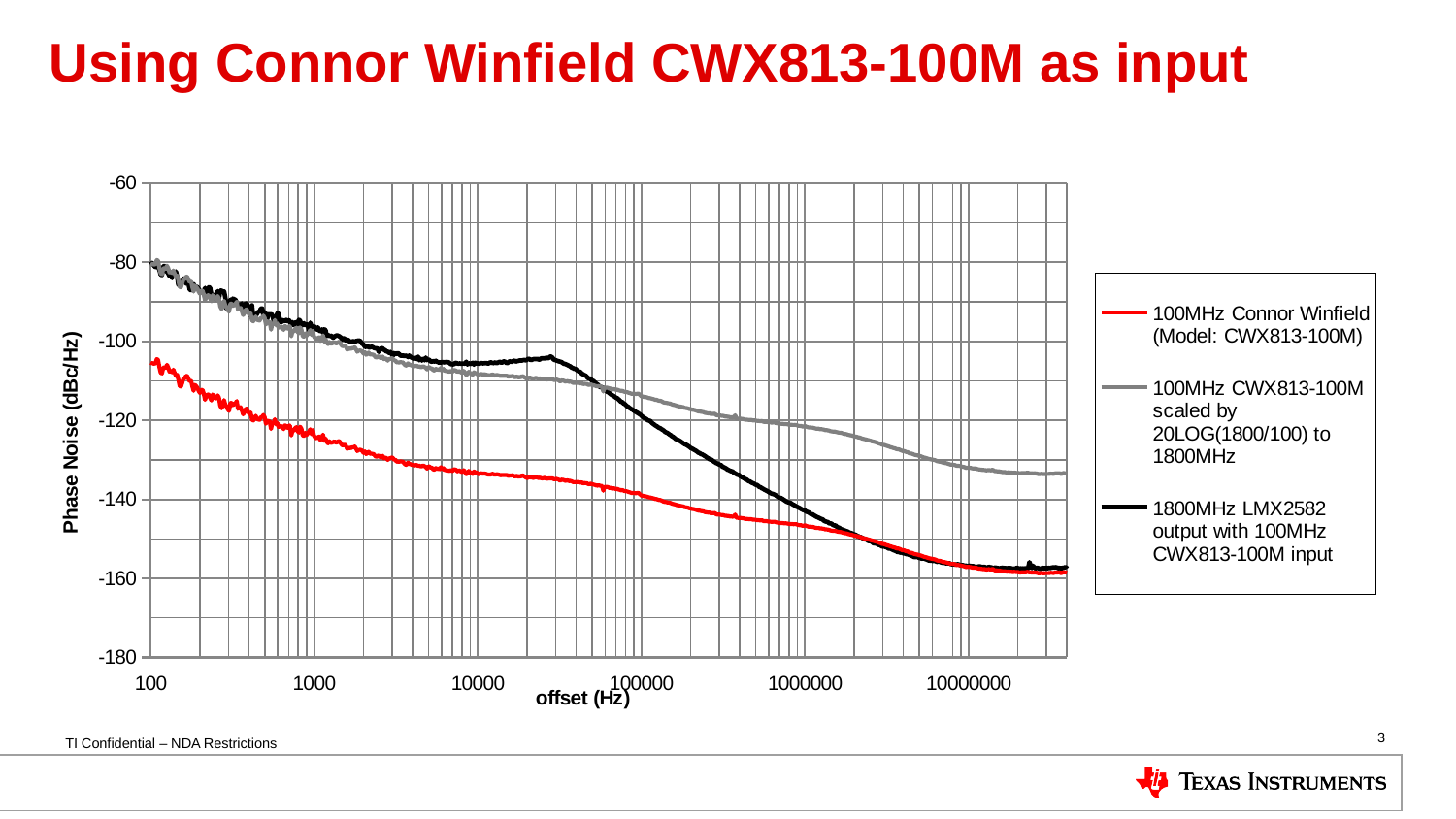
Is the value of the 1800MHz LMX2582 output series at 10000 Hz offset greater or less than -120? greater Is the value of the 100MHz CWX813-100M scaled to 1800MHz series at 10000000 Hz offset greater or less than -140? greater How many series does the legend list? 3 What kind of chart is shown on the slide? line chart At 1000 Hz offset, which series has the higher phase noise: the 100MHz Connor Winfield series or the 100MHz CWX813-100M scaled to 1800MHz series? 100MHz CWX813-100M scaled to 1800MHz Is the value of the 100MHz CWX813-100M scaled by 20LOG(1800/100) to 1800MHz series at 100 Hz offset greater or less than -100? greater At 100000 Hz offset, which series has the higher phase noise: the 1800MHz LMX2582 output series or the 100MHz CWX813-100M scaled to 1800MHz series? 100MHz CWX813-100M scaled to 1800MHz What is the label of the y axis? Phase Noise (dBc/Hz) Does the 100MHz Connor Winfield (Model: CWX813-100M) series generally rise or fall as the offset increases? fall Which colour is used for the 1800MHz LMX2582 output with 100MHz CWX813-100M input series? black